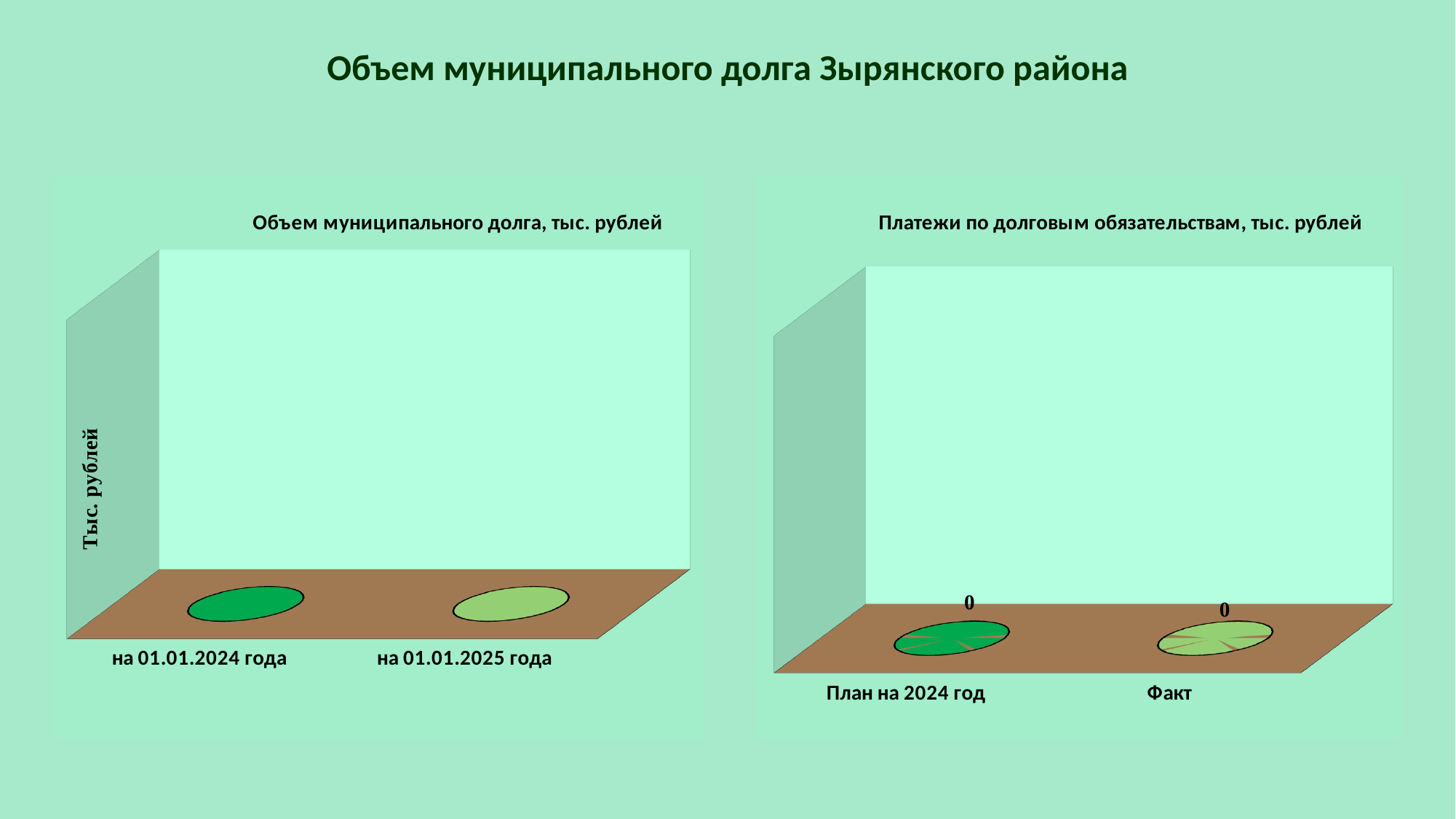
How many categories are shown in the chart titled 'Объем муниципального долга, тыс. рублей'? 2 What kind of chart is the chart on the right of the slide? Bar chart In the chart titled 'Платежи по долговым обязательствам, тыс. рублей', what is the value for 'Факт'? 0 How many categories are shown in the chart titled 'Платежи по долговым обязательствам, тыс. рублей'? 2 What is the vertical axis title of the chart on the left of the slide? Тыс. рублей In the chart titled 'Платежи по долговым обязательствам, тыс. рублей', what is the value for 'План на 2024 год'? 0 What are the two category labels on the x axis of the chart titled 'Объем муниципального долга, тыс. рублей'? на 01.01.2024 года; на 01.01.2025 года In the chart titled 'Платежи по долговым обязательствам, тыс. рублей', what is the difference between the value for 'План на 2024 год' and the value for 'Факт'? 0 What kind of chart is the chart on the left of the slide? Bar chart